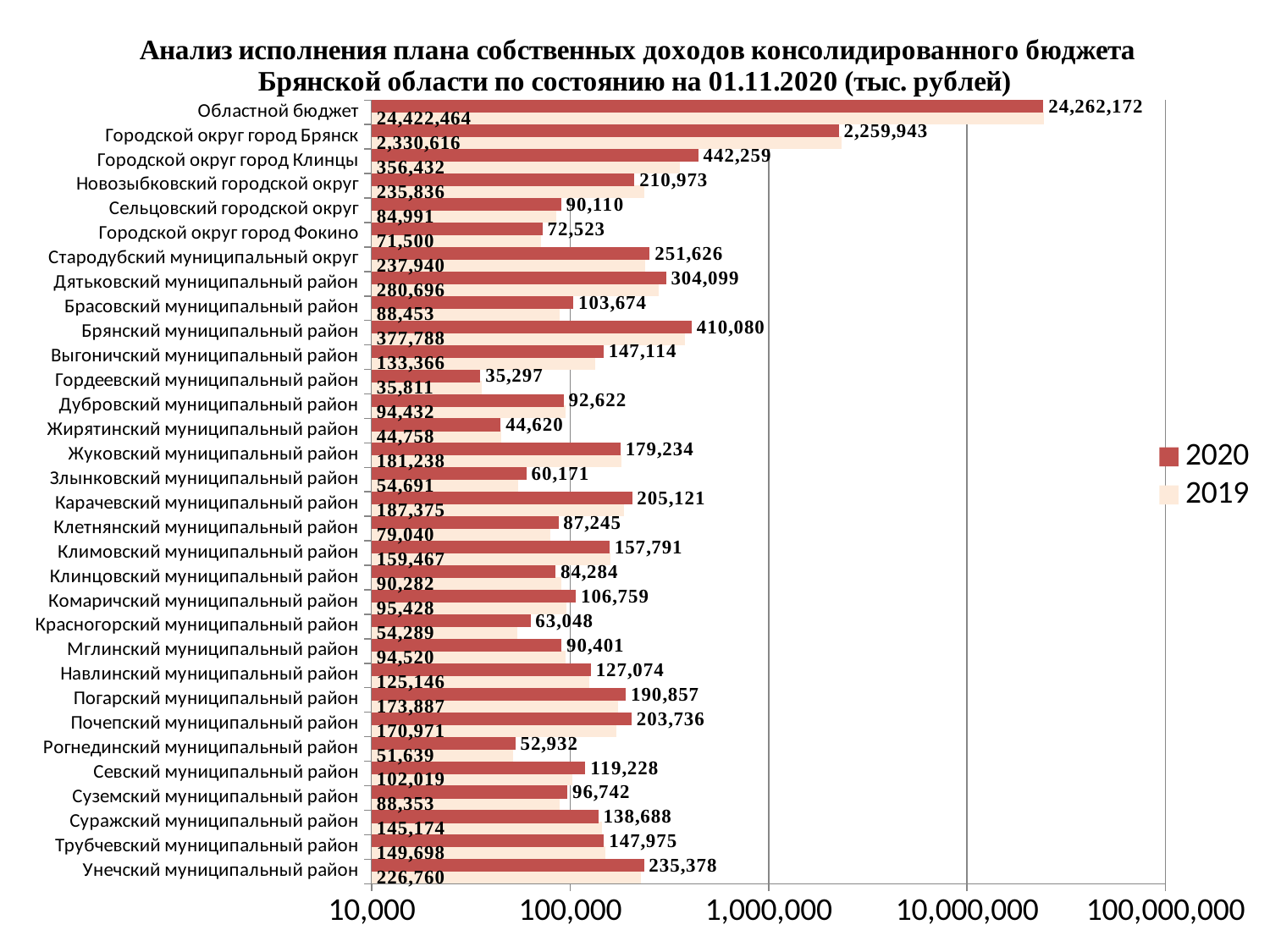
What is the 2020 value for Унечский муниципальный район? 235,378 Which category has the highest 2020 value? Областной бюджет How many categories (budgets) are plotted on the chart? 32 What kind of chart is shown on the slide? bar chart Is the 2020 value for Дятьковский муниципальный район greater or less than 100,000? greater What is the 2020 value for Городской округ город Клинцы? 442,259 Which series is shown in dark red in the legend? 2020 Which is larger for Городской округ город Брянск: the 2020 value or the 2019 value? 2019 How many series does the legend list? 2 What is the difference between the 2020 and 2019 values for Почепский муниципальный район? 32,765 Which category has the lowest 2020 value? Гордеевский муниципальный район What is the 2019 value for Брянский муниципальный район? 377,788